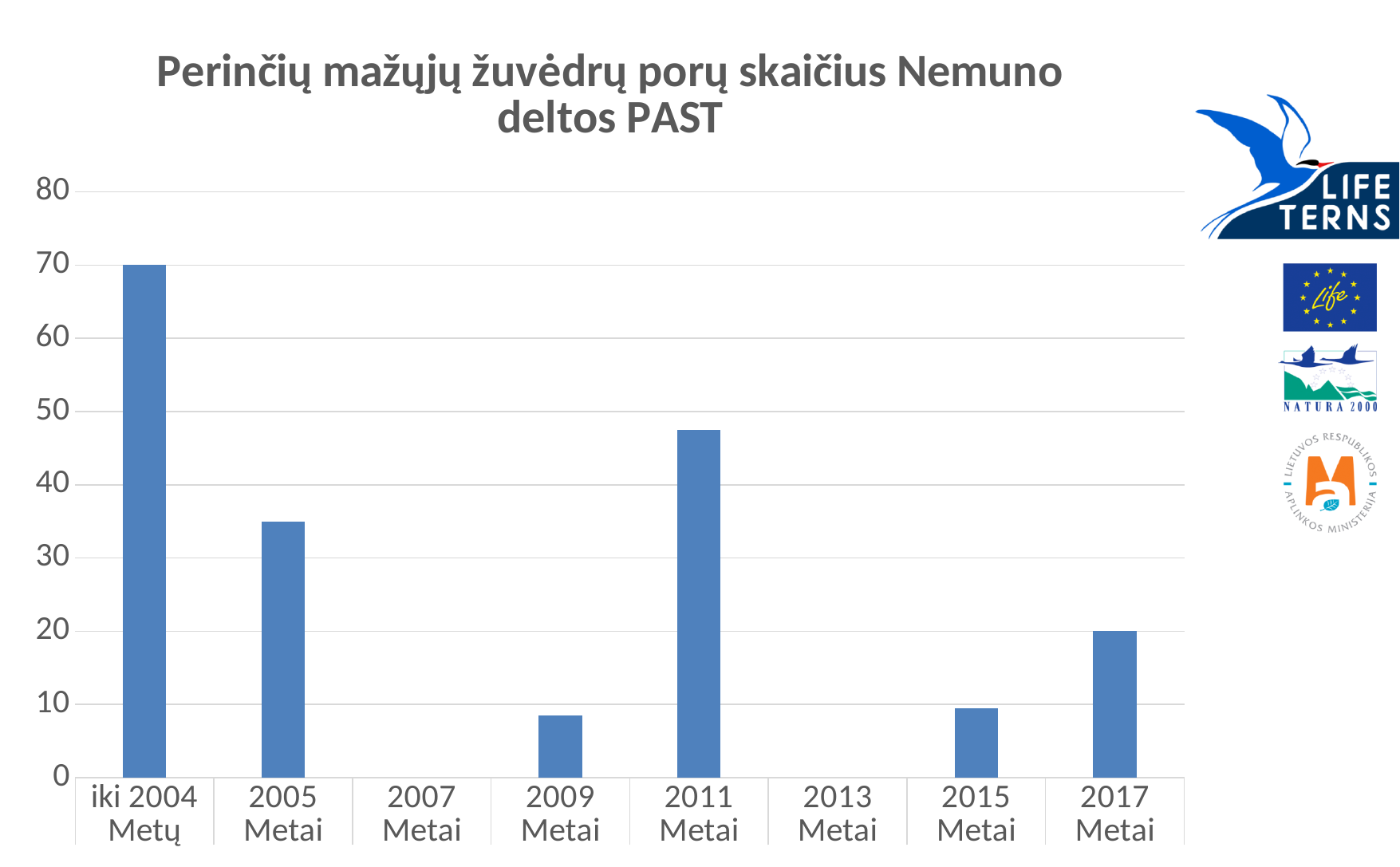
How many categories are shown on the x axis of the chart? 8 Which category has the highest value in the chart? iki 2004 Metų Which has the larger value, 2015 Metai or 2017 Metai? 2017 Metai What is the value for 2017 Metai? 20 What kind of chart is shown on the slide? bar chart Which has the larger value, 2005 Metai or 2011 Metai? 2011 Metai Is the value for 2011 Metai greater or less than 40? greater What is the value for iki 2004 Metų? 70 Is the value for 2009 Metai greater or less than 10? less What is the difference between the values for iki 2004 Metų and 2017 Metai? 50 Is the value for 2005 Metai greater or less than 30? greater What is the title of the chart? Perinčių mažųjų žuvėdrų porų skaičius Nemuno deltos PAST